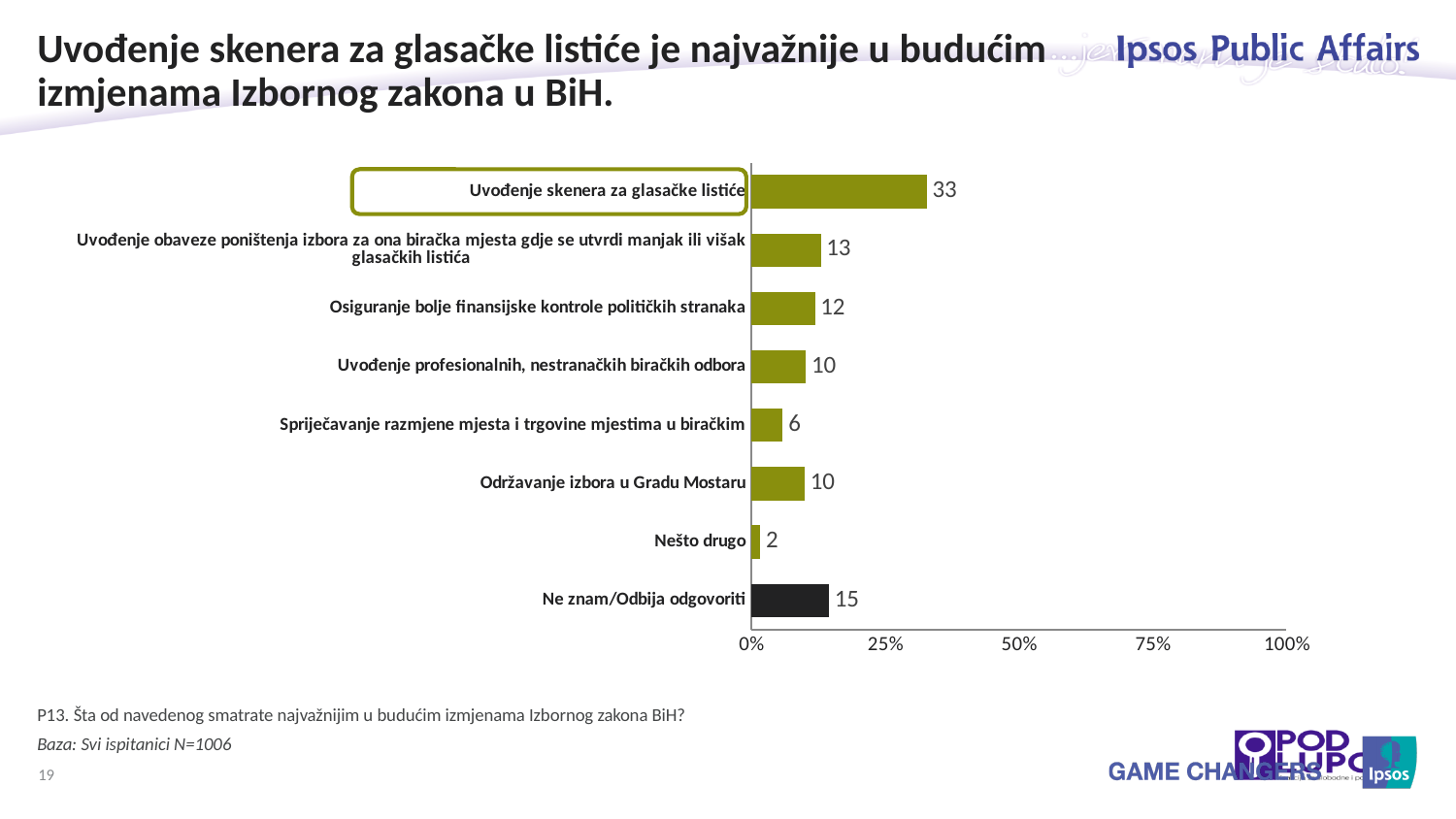
How many categories are shown in the chart? 8 Which category has the highest value? Uvođenje skenera za glasačke listiće Which category has the lowest value? Nešto drugo What value is shown for "Ne znam/Odbija odgovoriti"? 15 What value is shown for "Osiguranje bolje finansijske kontrole političkih stranaka"? 12 What value is shown for "Uvođenje skenera za glasačke listiće"? 33 What is the difference between the value for "Uvođenje skenera za glasačke listiće" and the value for "Ne znam/Odbija odgovoriti"? 18 Is the value for "Uvođenje skenera za glasačke listiće" greater or less than 25%? greater What value is shown for "Nešto drugo"? 2 What kind of chart is shown on the slide? bar chart Which is larger: the value for "Sprječavanje razmjene mjesta i trgovine mjestima u biračkim" or the value for "Održavanje izbora u Gradu Mostaru"? Održavanje izbora u Gradu Mostaru What is the highest value shown on the x axis? 100%